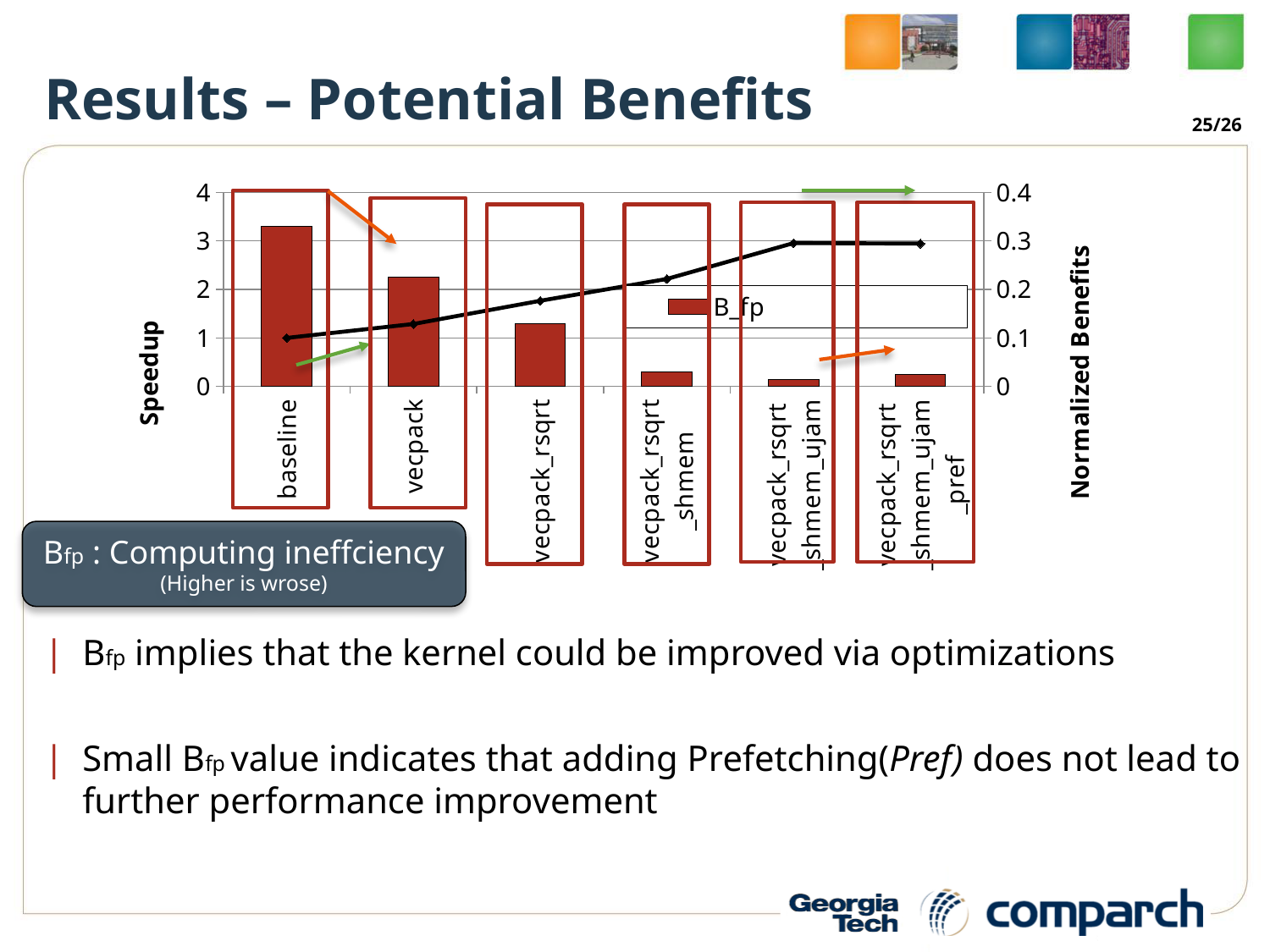
Does the black line rise or fall from baseline to vecpack_rsqrt_shmem_ujam? rise Is the bar for vecpack_rsqrt greater or less than 1 on the left axis? greater How many categories are shown on the x axis of the chart? 6 Is the bar for baseline greater or less than 3 on the left axis? greater What series name does the chart legend show? B_fp Do the bar values rise or fall from baseline to vecpack_rsqrt_shmem_ujam? fall Which category has the tallest bar in the chart? baseline What is the title of the left vertical axis of the chart? Speedup Is the bar for vecpack greater or less than 2 on the left axis? greater Which bar is taller, vecpack or vecpack_rsqrt? vecpack Which bar is taller, vecpack_rsqrt_shmem or vecpack_rsqrt_shmem_ujam? vecpack_rsqrt_shmem